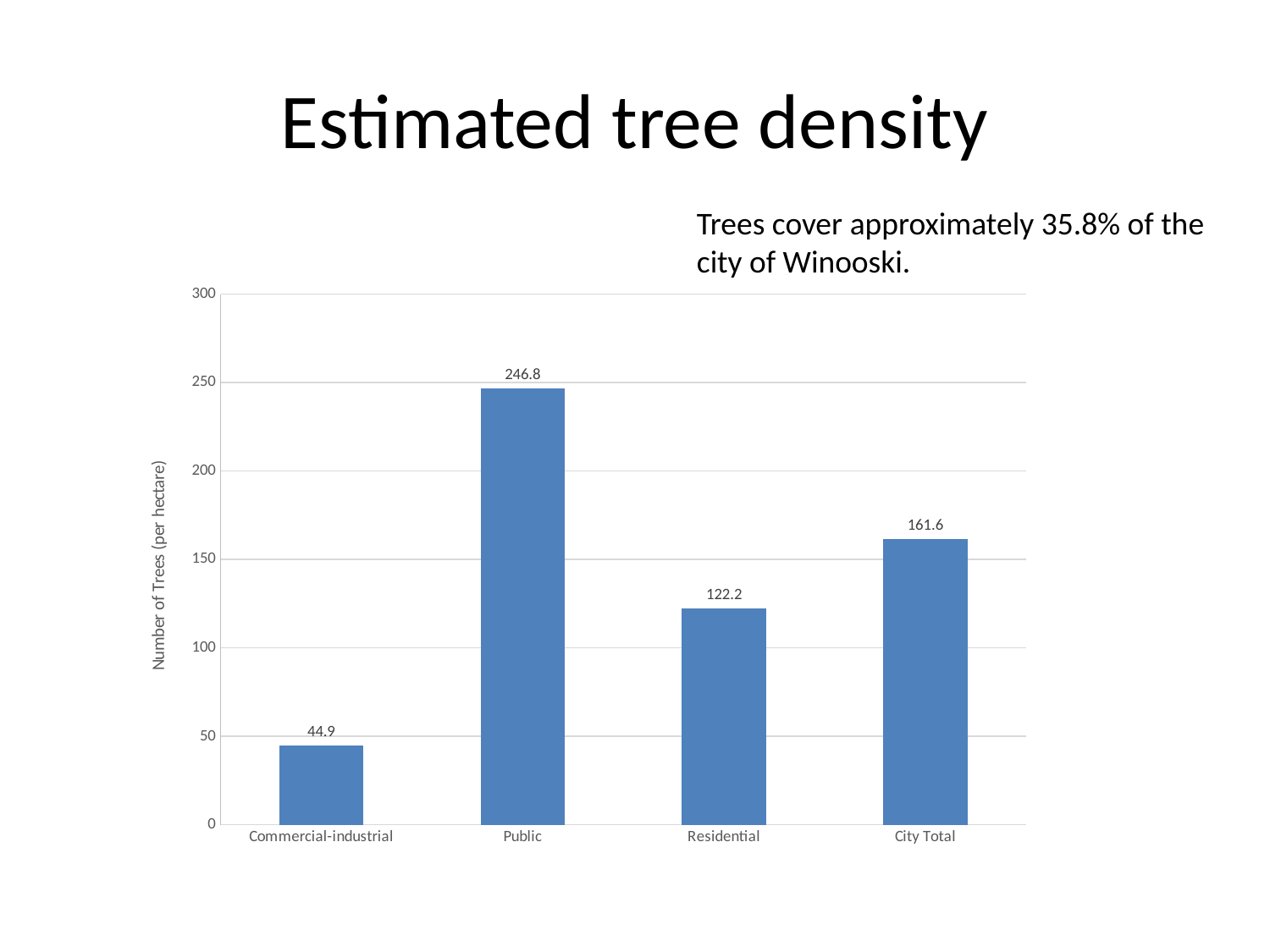
What kind of chart is shown on the slide? bar chart What is the number of trees per hectare for Residential land? 122.2 What is the label of the vertical axis? Number of Trees (per hectare) Is the value for Commercial-industrial greater or less than 50? less What is the number of trees per hectare for Commercial-industrial land? 44.9 Which category has the lowest tree density? Commercial-industrial How many categories are shown on the x axis? 4 What is the City Total number of trees per hectare? 161.6 What is the difference in trees per hectare between Public and Residential? 124.6 What is the number of trees per hectare for Public land? 246.8 Which category has the highest tree density? Public Which has a higher tree density, Residential or City Total? City Total